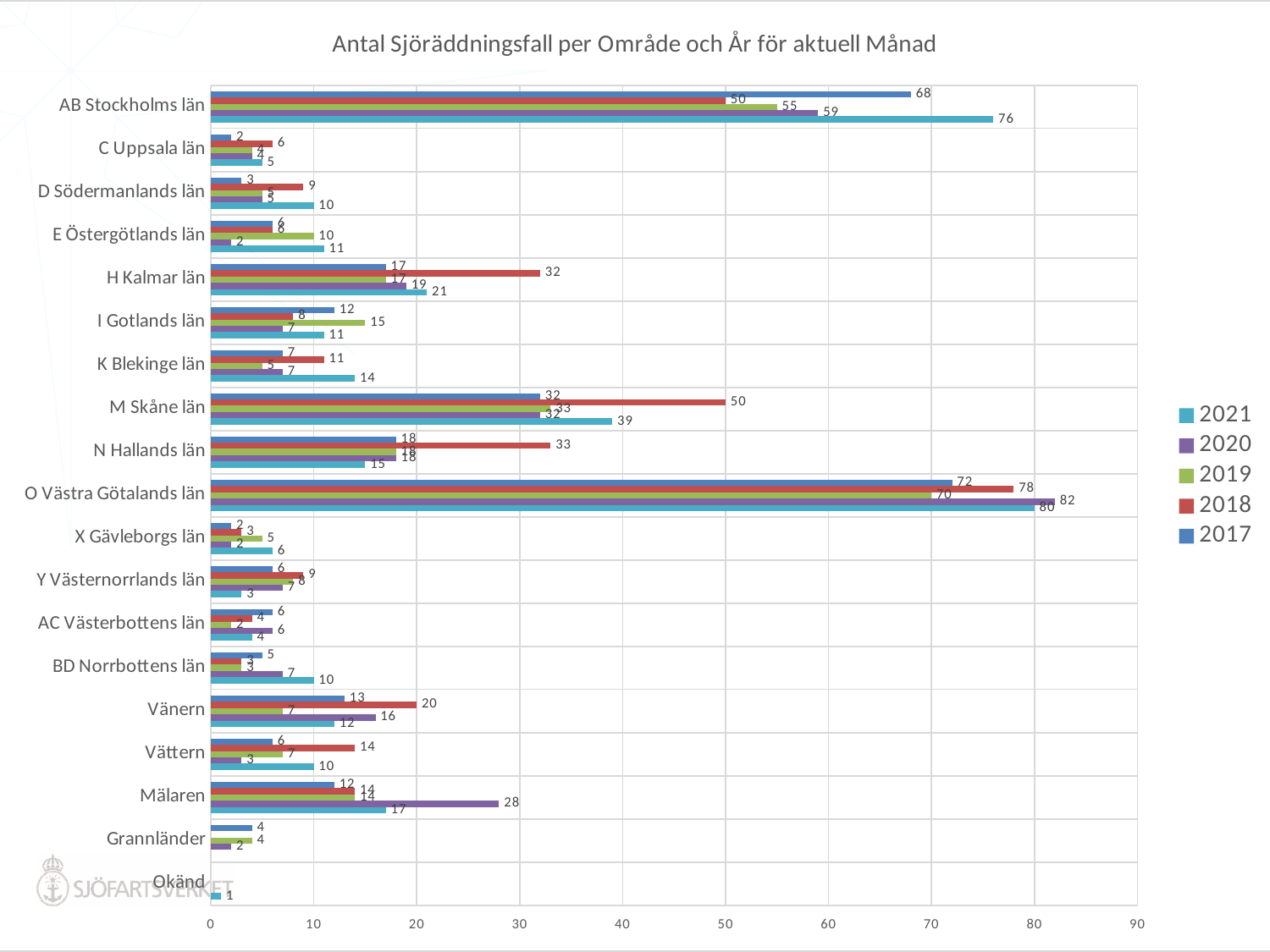
Which year has the lowest value for M Skåne län? 2017 and 2020 (both 32) What kind of chart is shown on the slide? bar chart What is the value for O Västra Götalands län in 2020? 82 What is the title of the chart? Antal Sjöräddningsfall per Område och År för aktuell Månad Which area has the highest value in the 2018 series? O Västra Götalands län How many areas (categories) are listed on the vertical axis? 19 What is the value for H Kalmar län in 2018? 32 Which is larger for Vänern: the 2018 value or the 2020 value? 2018 What is the difference between the 2021 and 2017 values for AB Stockholms län? 8 How many series does the legend list? 5 What is the value for AB Stockholms län in 2021? 76 What is the value for Mälaren in 2020? 28